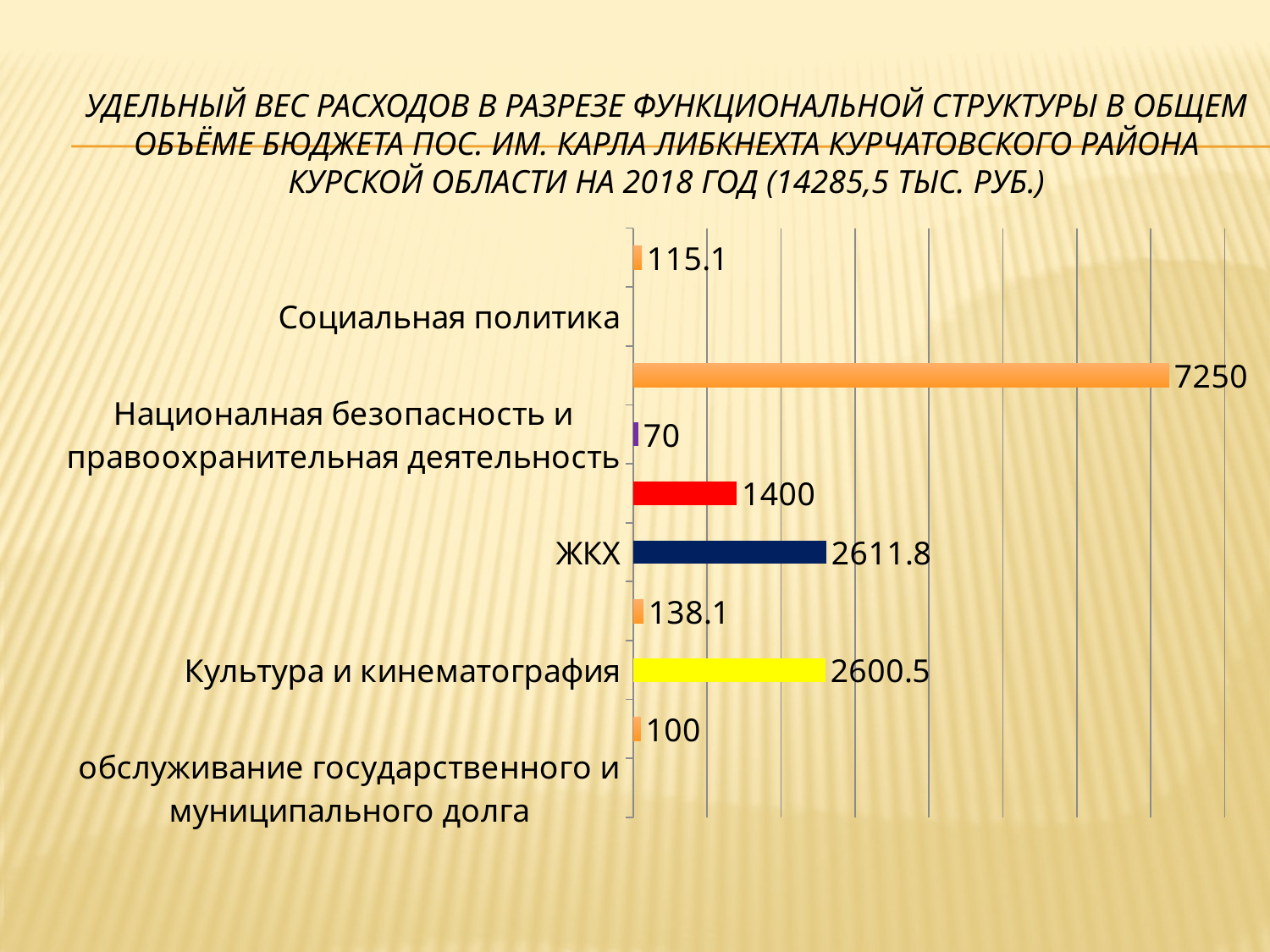
What is the difference between the values for ЖКХ and Культура и кинематография? 11.3 What colour is the bar for ЖКХ? dark blue What is the value shown for ЖКХ? 2611.8 What is the smallest value labelled on any bar in the chart? 70 According to the slide title, what is the total budget volume for 2018? 14285,5 тыс. руб. Which is larger, the value for ЖКХ or the value for Культура и кинематография? ЖКХ What is the value shown for Националная безопасность и правоохранительная деятельность? 70 How many bars are plotted in the chart? 8 What is the largest value labelled on any bar in the chart? 7250 What is the value shown for Культура и кинематография? 2600.5 What type of chart is shown on the slide? bar chart